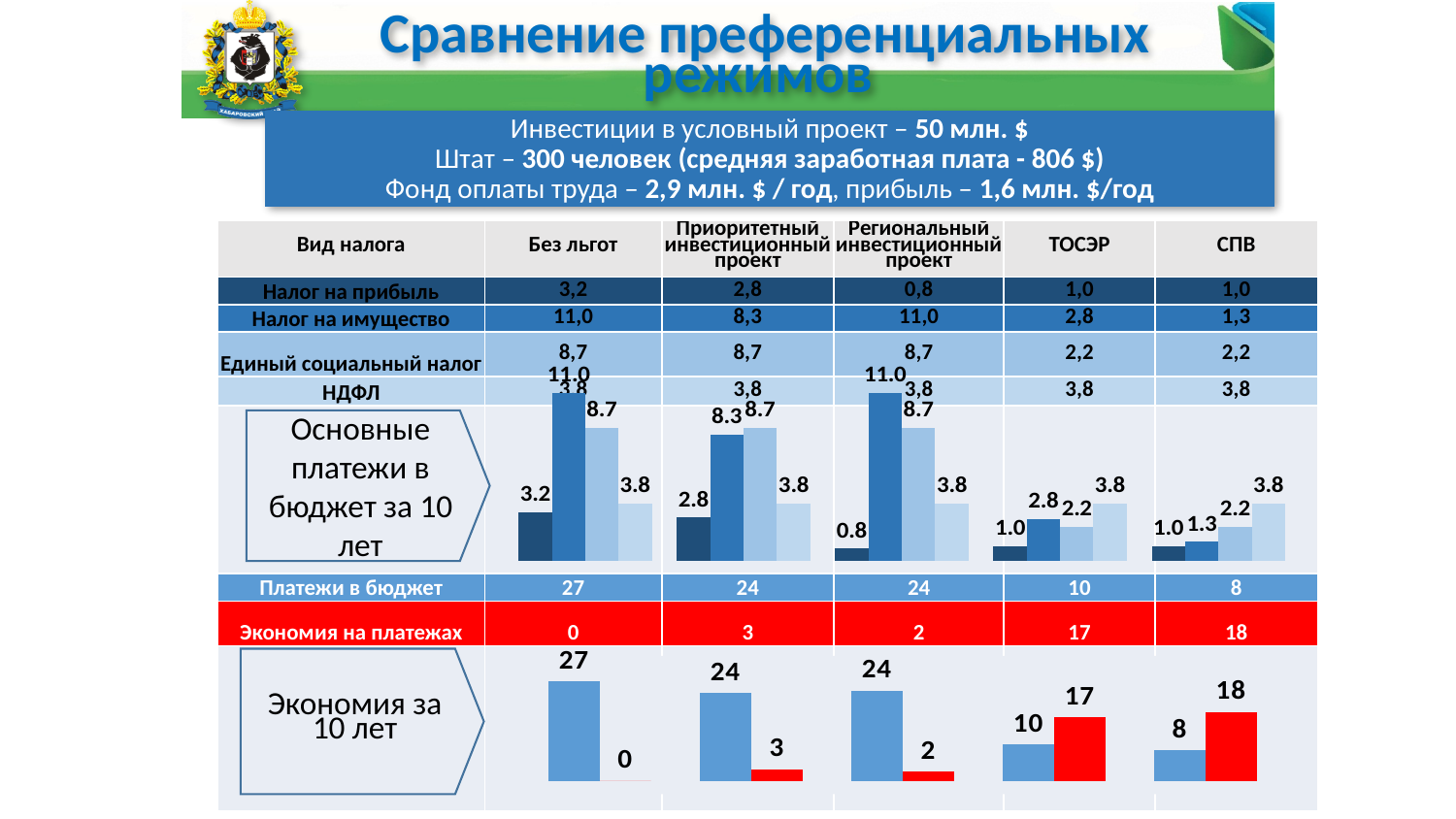
In the 'Основные платежи в бюджет за 10 лет' chart, what is the value of the tallest bar for Региональный инвестиционный проект? 11.0 In the 'Экономия за 10 лет' chart, what is the value of the red savings bar for СПВ? 18 In the 'Экономия за 10 лет' chart, how many regimes (groups of bars) are shown? 5 In the 'Экономия за 10 лет' chart, which regime has the lowest blue payments bar? СПВ In the 'Экономия за 10 лет' chart, what is the difference between the savings for ТОСЭР and the savings for Приоритетный инвестиционный проект? 14 In the 'Основные платежи в бюджет за 10 лет' chart, how many bars are shown for each regime? 4 In the 'Экономия за 10 лет' chart, which regime has the highest red savings bar? СПВ In the 'Экономия за 10 лет' chart, which is larger for ТОСЭР: the blue payments bar or the red savings bar? the red savings bar (17) In the 'Экономия за 10 лет' chart, what is the value of the blue payments bar for Без льгот? 27 What type of chart is used in the 'Экономия за 10 лет' row? bar chart In the 'Основные платежи в бюджет за 10 лет' chart, what is the value of the first (dark blue) bar for Приоритетный инвестиционный проект? 2.8 In the 'Основные платежи в бюджет за 10 лет' chart, what is the difference between the second bar for Без льгот (11.0) and the second bar for СПВ (1.3)? 9.7